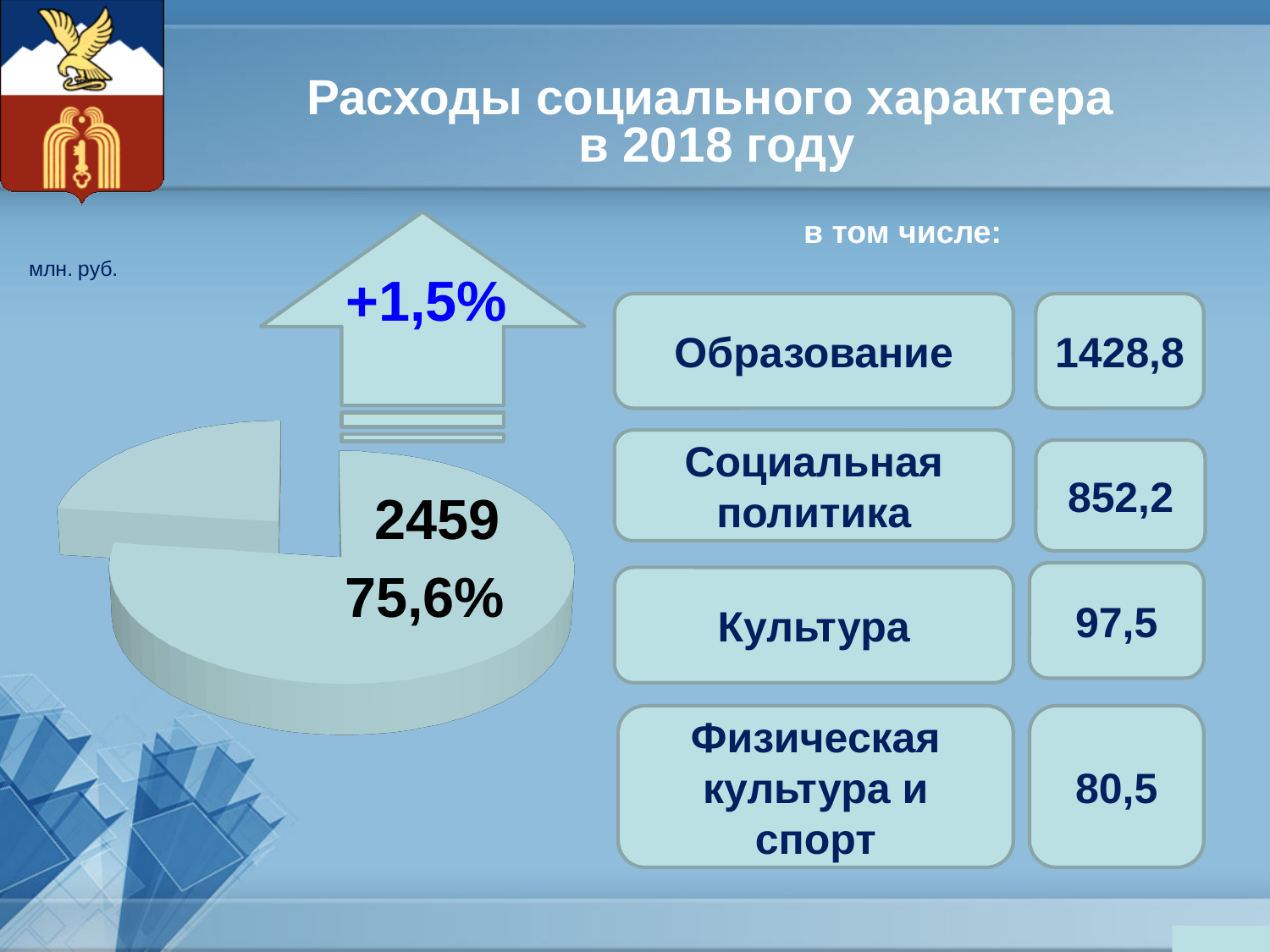
Which slice of the pie chart is larger, the labelled slice or the unlabelled slice? the labelled slice (75,6%) According to the breakdown on the right of the slide, which item has the lowest value? Физическая культура и спорт What kind of chart is shown on the left of the slide? pie chart In what units are the values on the slide given? млн. руб. What is the title of the slide containing the pie chart? Расходы социального характера в 2018 году What percentage change is shown on the arrow above the pie chart? +1,5% Is the share of the labelled slice of the pie chart greater or less than 50%? greater What value is printed on the large slice of the pie chart? 2459 What share of the pie does the large labelled slice represent? 75,6% According to the breakdown on the right of the slide, what is the difference between Образование and Социальная политика? 576,6 How many slices does the pie chart have? 2 According to the breakdown on the right of the slide, what is the value for Образование? 1428,8